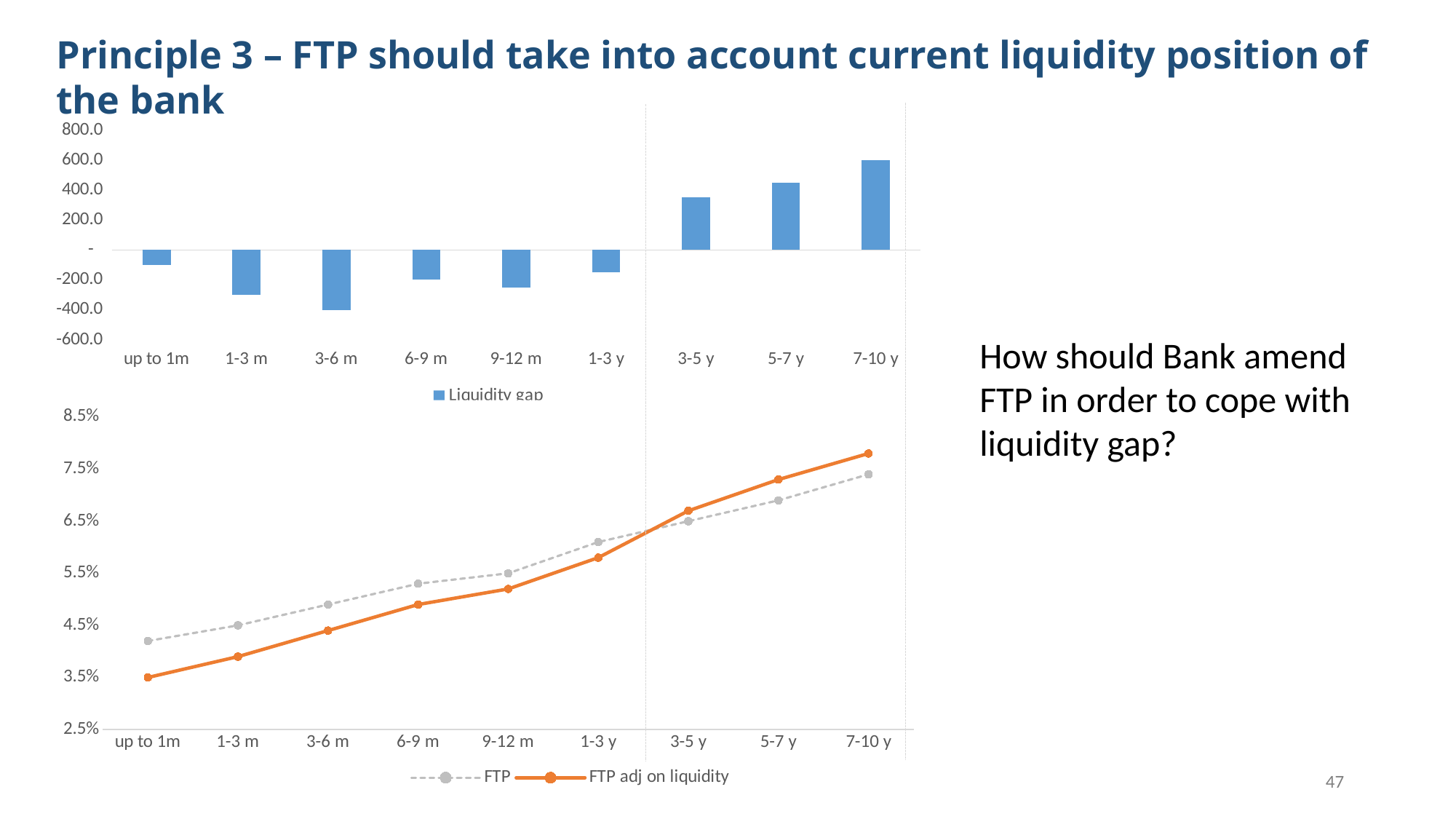
How many series does the legend of the bottom chart list? 2 What kind of chart is the bottom chart on the slide? line chart In the bottom chart, at 7-10 y, which series has the higher value: FTP or FTP adj on liquidity? FTP adj on liquidity In the bottom chart, at up to 1m, which series has the higher value: FTP or FTP adj on liquidity? FTP What kind of chart is the top chart on the slide? bar chart In the top chart (Liquidity gap), is the value for 1-3 m greater or less than -200.0? less In the top chart (Liquidity gap), which time bucket has the lowest (most negative) liquidity gap? 3-6 m In the top chart (Liquidity gap), which time bucket has the highest liquidity gap? 7-10 y In the top chart (Liquidity gap), is the value for 7-10 y greater or less than 400.0? greater In the bottom chart, do the FTP adj on liquidity values rise or fall from up to 1m to 7-10 y? rise In the top chart (Liquidity gap), how many time buckets are shown on the x axis? 9 In the bottom chart, is the FTP adj on liquidity value for 7-10 y greater or less than 7.5%? greater